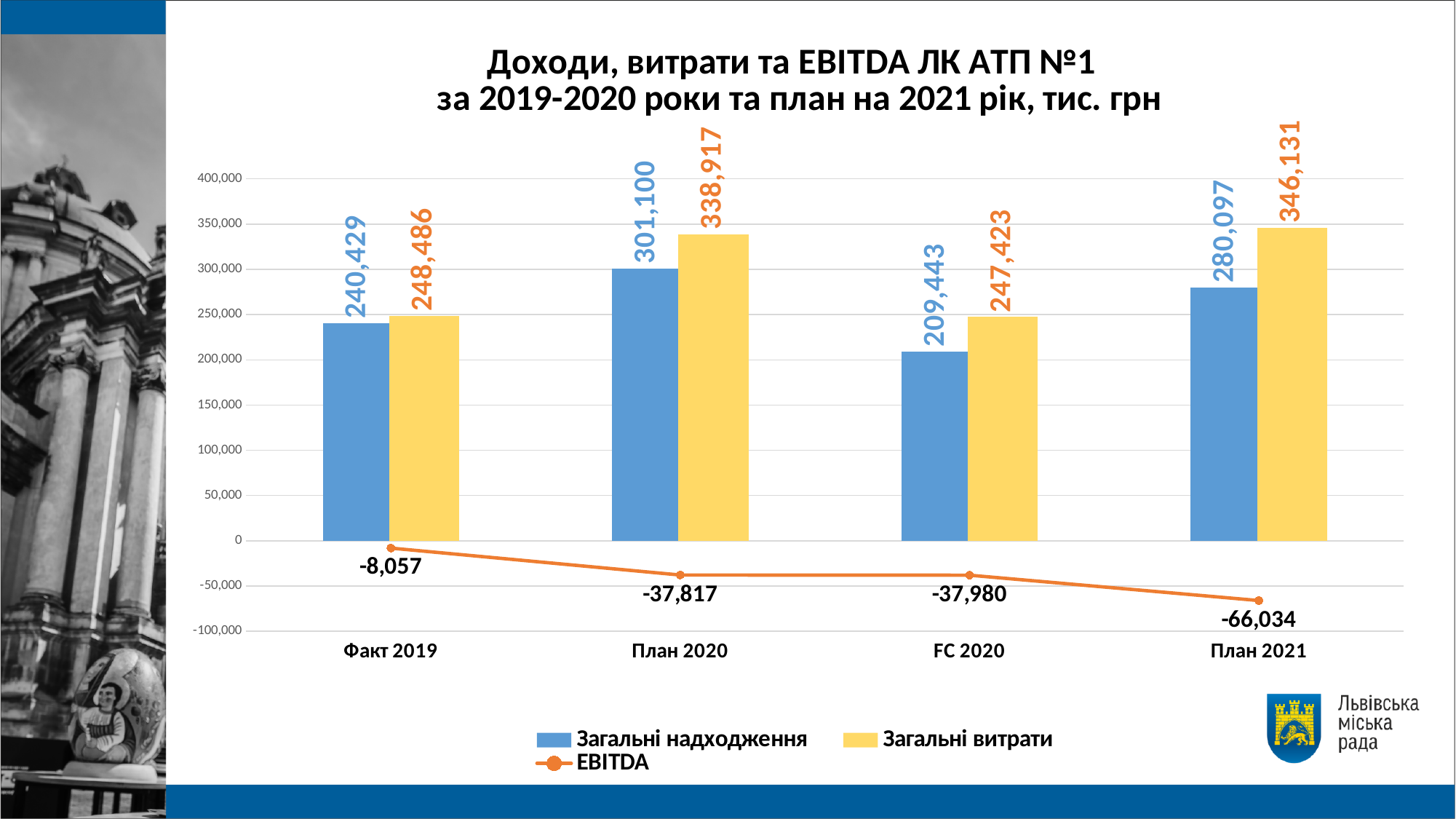
What is the value of Загальні витрати for План 2021? 346,131 Which category has the highest value of Загальні надходження? План 2020 Does the EBITDA line rise or fall from Факт 2019 to План 2021? fall What is the value of Загальні витрати for Факт 2019? 248,486 Which is larger for FC 2020: Загальні надходження or Загальні витрати? Загальні витрати What is the EBITDA value for FC 2020? -37,980 What is the difference between Загальні витрати and Загальні надходження for План 2021? 66,034 How many categories are shown on the x axis? 4 How many series does the legend list? 3 Which category has the lowest value of Загальні надходження? FC 2020 Which category has the lowest EBITDA value? План 2021 What is the value of Загальні надходження for План 2020? 301,100